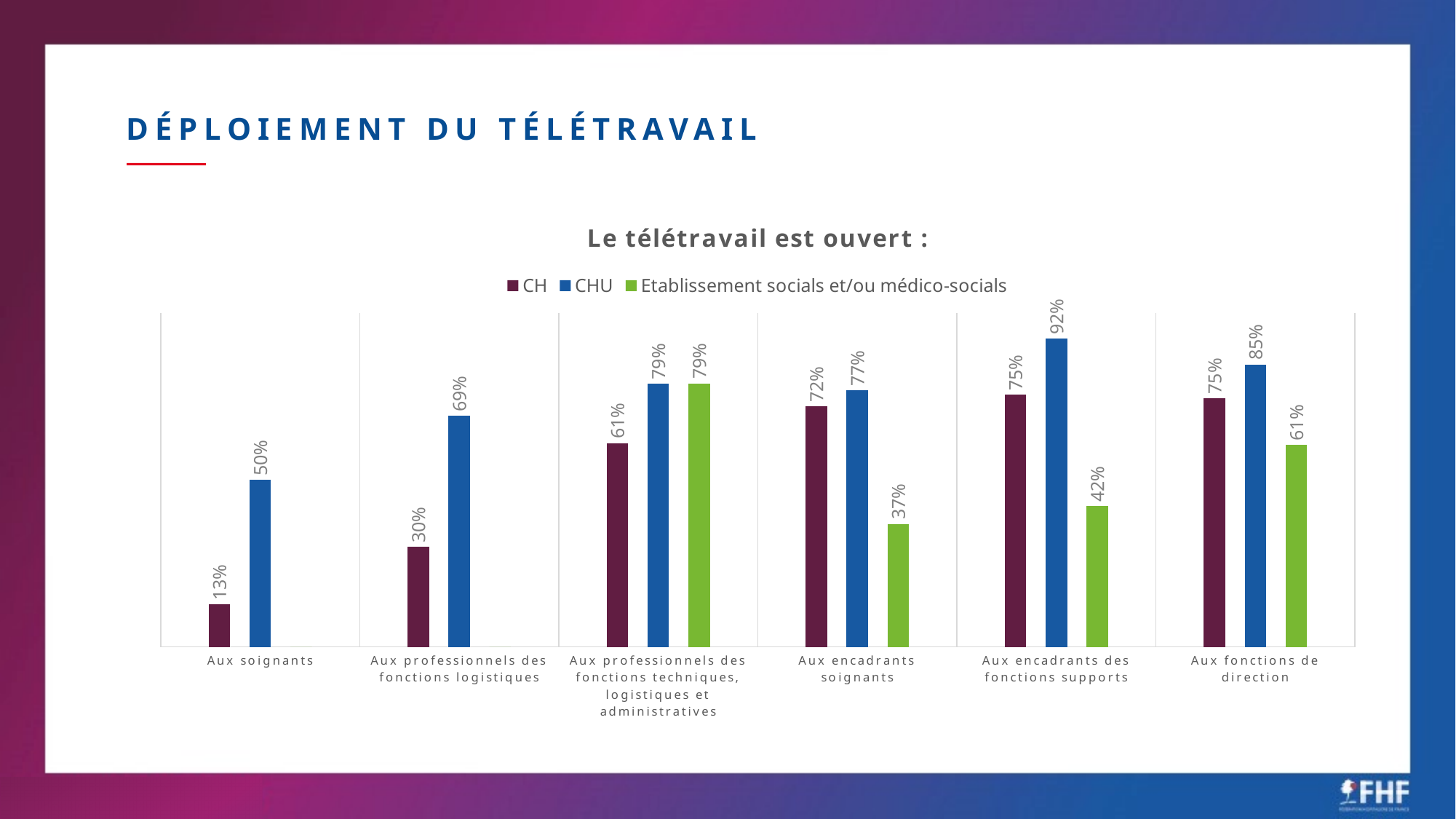
How many series does the legend list? 3 What is the value for CH in the 'Aux professionnels des fonctions logistiques' category? 30% Which category has the highest CHU value? Aux encadrants des fonctions supports What is the value for CHU in the 'Aux soignants' category? 50% What is the difference between the CHU and Etablissement socials et/ou médico-socials values for 'Aux encadrants des fonctions supports'? 50% What is the title of the chart? Le télétravail est ouvert : What kind of chart is shown on the slide? Bar chart In the 'Aux fonctions de direction' category, which is larger: the CHU value or the Etablissement socials et/ou médico-socials value? CHU Which category has the lowest CH value? Aux soignants What is the difference between the CHU and CH values for 'Aux professionnels des fonctions logistiques'? 39% What is the value for Etablissement socials et/ou médico-socials in the 'Aux encadrants soignants' category? 37% How many categories are shown on the x axis? 6